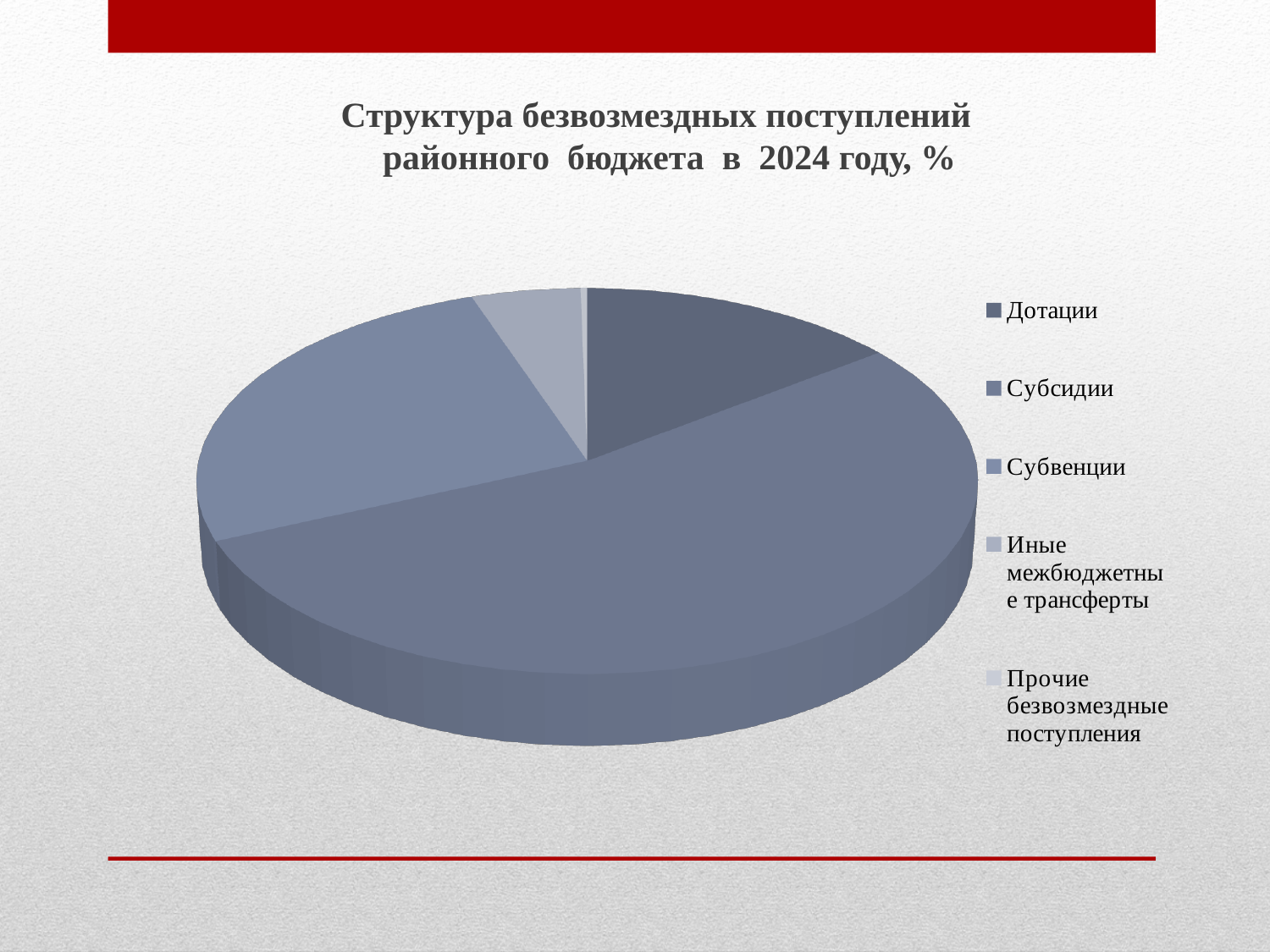
Which year does the chart describe? 2024 What is the title of the chart? Структура безвозмездных поступлений районного бюджета в 2024 году, % How many categories does the legend list? 5 Which slice is larger, Субсидии or Дотации? Субсидии What kind of chart is shown on the slide? pie chart Which slice is larger, Субсидии or Субвенции? Субсидии Which category has the largest slice of the pie? Субсидии Which slice is larger, Дотации or Иные межбюджетные трансферты? Дотации